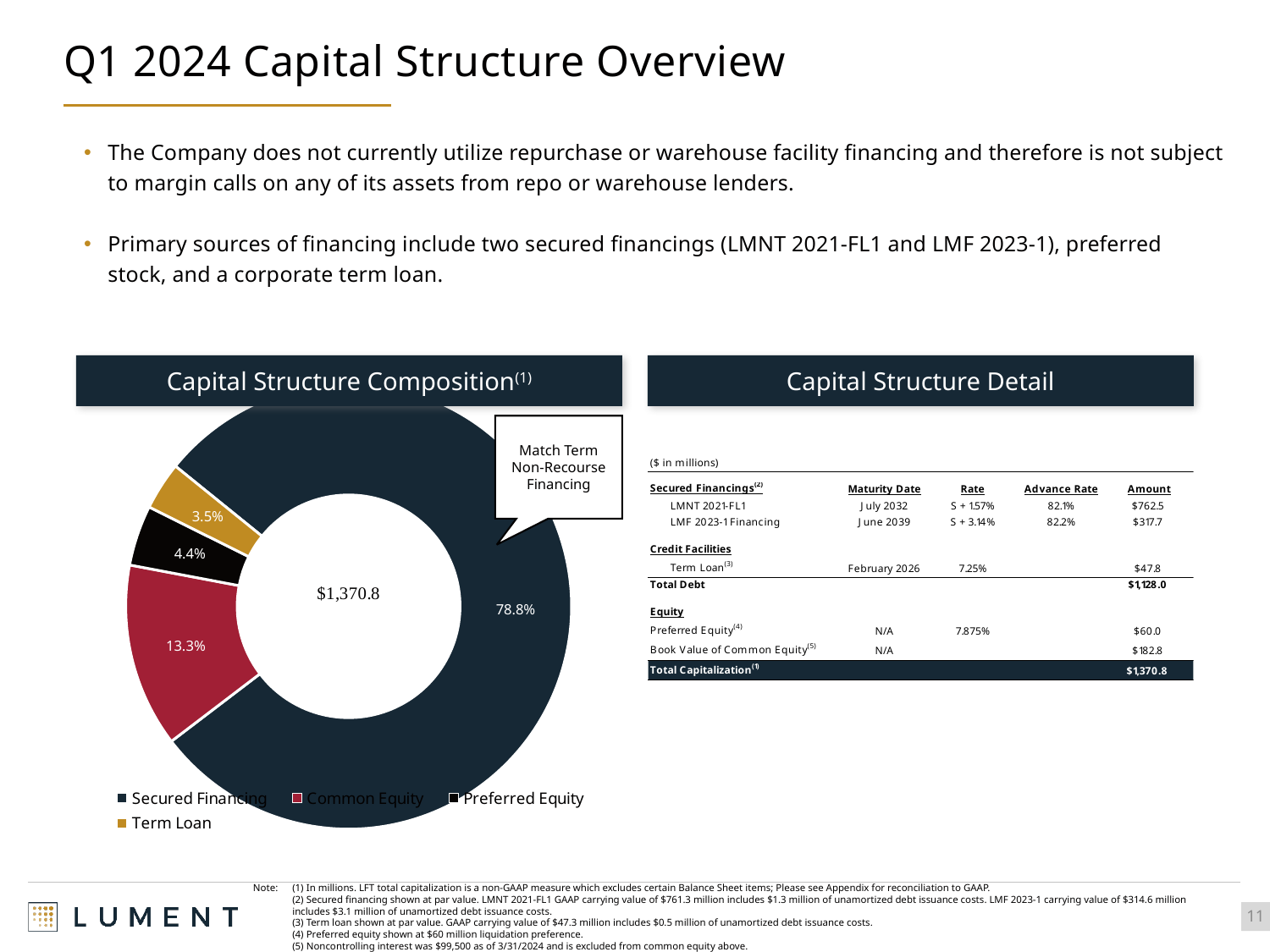
What value is printed in the center of the donut chart? $1,370.8 Which slice is larger, Preferred Equity or Term Loan? Preferred Equity What is the difference in percentage points between the Secured Financing slice and the Common Equity slice? 65.5 percentage points What kind of chart is shown under "Capital Structure Composition"? Pie chart (donut) What share of the capital structure is the Term Loan? 3.5% Which category has the smallest slice in the Capital Structure Composition chart? Term Loan Which category has the largest slice in the Capital Structure Composition chart? Secured Financing What share of the capital structure is Common Equity? 13.3% What share of the capital structure is Secured Financing? 78.8% How many categories does the legend of the Capital Structure Composition chart list? 4 What does the callout pointing to the Secured Financing slice say? Match Term Non-Recourse Financing